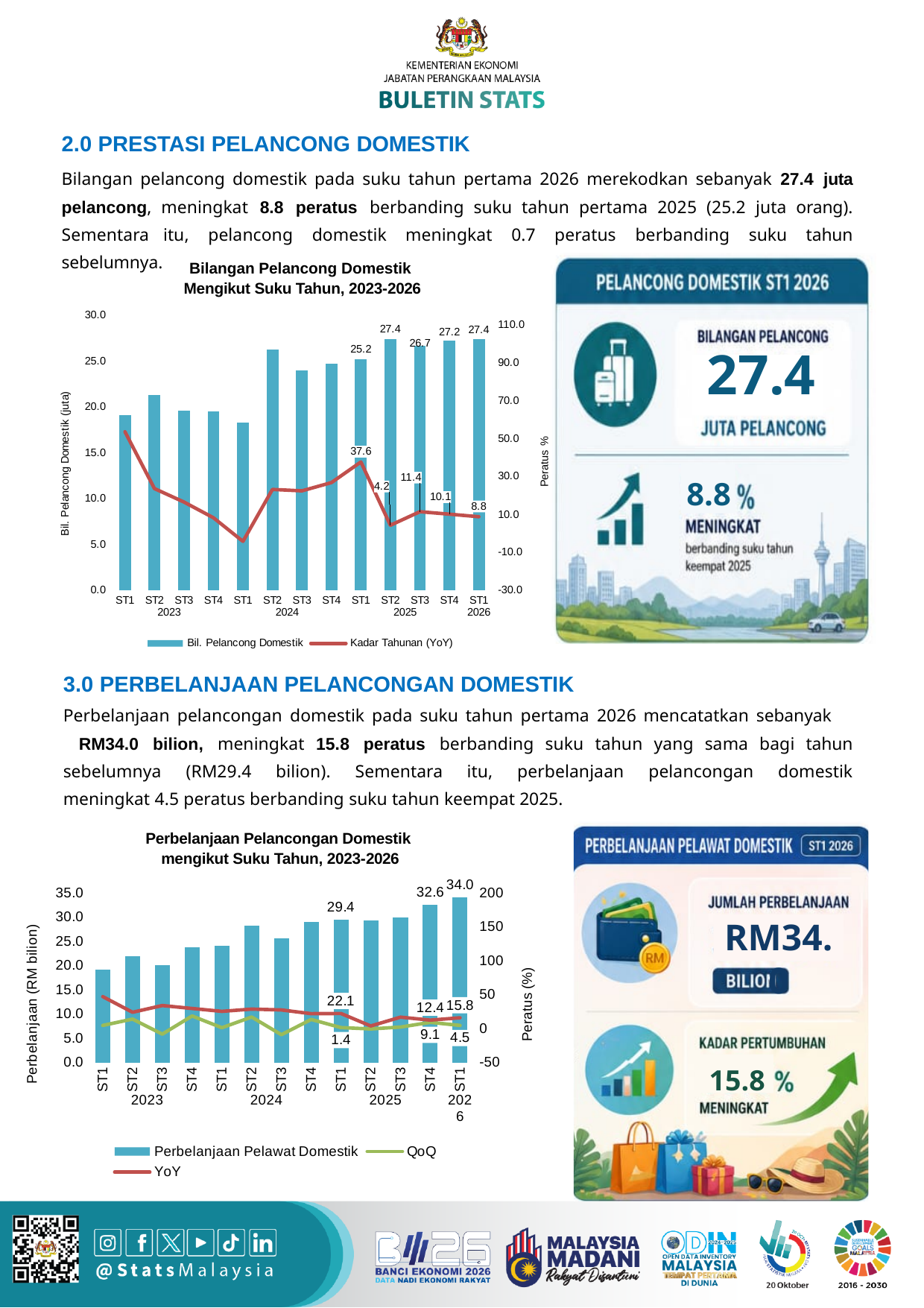
In the chart 'Bilangan Pelancong Domestik Mengikut Suku Tahun, 2023-2026', what is the Kadar Tahunan (YoY) value for ST1 2025? 37.6 In the chart 'Perbelanjaan Pelancongan Domestik mengikut Suku Tahun, 2023-2026', what is the difference between the ST1 2026 and ST4 2025 spending bars? 1.4 In the chart 'Bilangan Pelancong Domestik Mengikut Suku Tahun, 2023-2026', what is the difference between the ST2 2025 and ST3 2025 bar values? 0.7 How many quarterly bars are plotted in the chart 'Bilangan Pelancong Domestik Mengikut Suku Tahun, 2023-2026'? 13 In the chart 'Bilangan Pelancong Domestik Mengikut Suku Tahun, 2023-2026', is the bar value for ST1 2023 greater or less than 20.0? less How many series does the legend of the chart 'Bilangan Pelancong Domestik Mengikut Suku Tahun, 2023-2026' list? 2 In the chart 'Perbelanjaan Pelancongan Domestik mengikut Suku Tahun, 2023-2026', what is the spending (RM bilion) for ST1 2026? 34.0 In the chart 'Bilangan Pelancong Domestik Mengikut Suku Tahun, 2023-2026', what is the legend label of the line series? Kadar Tahunan (YoY) In the chart 'Bilangan Pelancong Domestik Mengikut Suku Tahun, 2023-2026', what is the number of domestic tourists (juta) for ST1 2026? 27.4 In the chart 'Perbelanjaan Pelancongan Domestik mengikut Suku Tahun, 2023-2026', which is larger for ST1 2026: the YoY value or the QoQ value? YoY How many series does the legend of the chart 'Perbelanjaan Pelancongan Domestik mengikut Suku Tahun, 2023-2026' list? 3